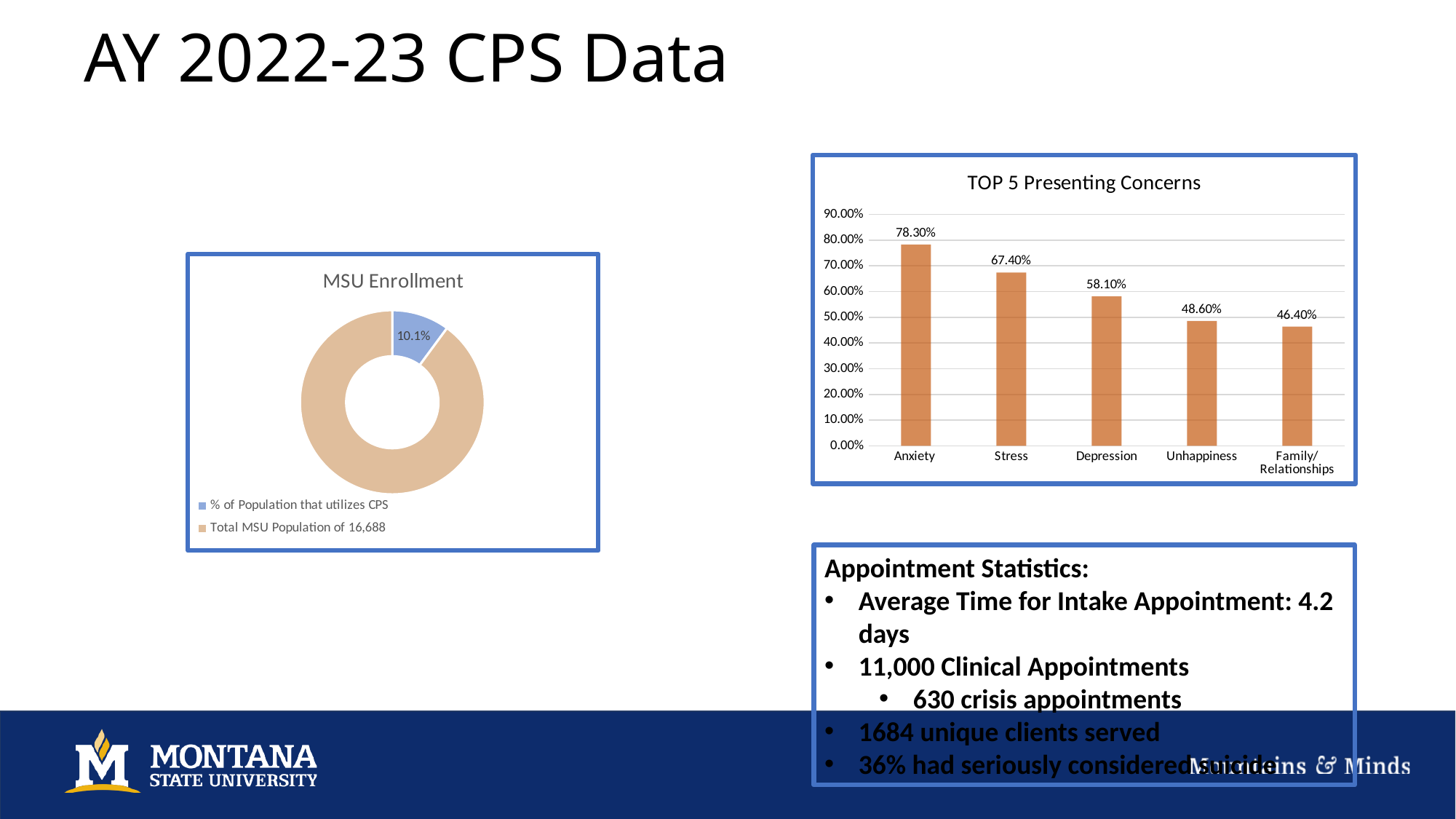
In the 'MSU Enrollment' chart, what share of the population utilizes CPS? 10.1% What kind of chart is the 'TOP 5 Presenting Concerns' chart? Bar chart In the 'TOP 5 Presenting Concerns' chart, what is the difference between the values for Stress and Unhappiness? 18.80% In the 'TOP 5 Presenting Concerns' chart, what is the value for Anxiety? 78.30% In the 'TOP 5 Presenting Concerns' chart, which concern has the lowest value? Family/Relationships In the 'TOP 5 Presenting Concerns' chart, do the values rise or fall from left to right along the x axis? Fall In the 'TOP 5 Presenting Concerns' chart, which is larger, the value for Stress or the value for Depression? Stress In the 'TOP 5 Presenting Concerns' chart, what is the value for Family/Relationships? 46.40% How many entries does the legend of the 'MSU Enrollment' chart list? 2 In the 'TOP 5 Presenting Concerns' chart, which concern has the highest value? Anxiety In the 'TOP 5 Presenting Concerns' chart, what is the value for Depression? 58.10% In the 'TOP 5 Presenting Concerns' chart, how many concerns are shown on the x axis? 5